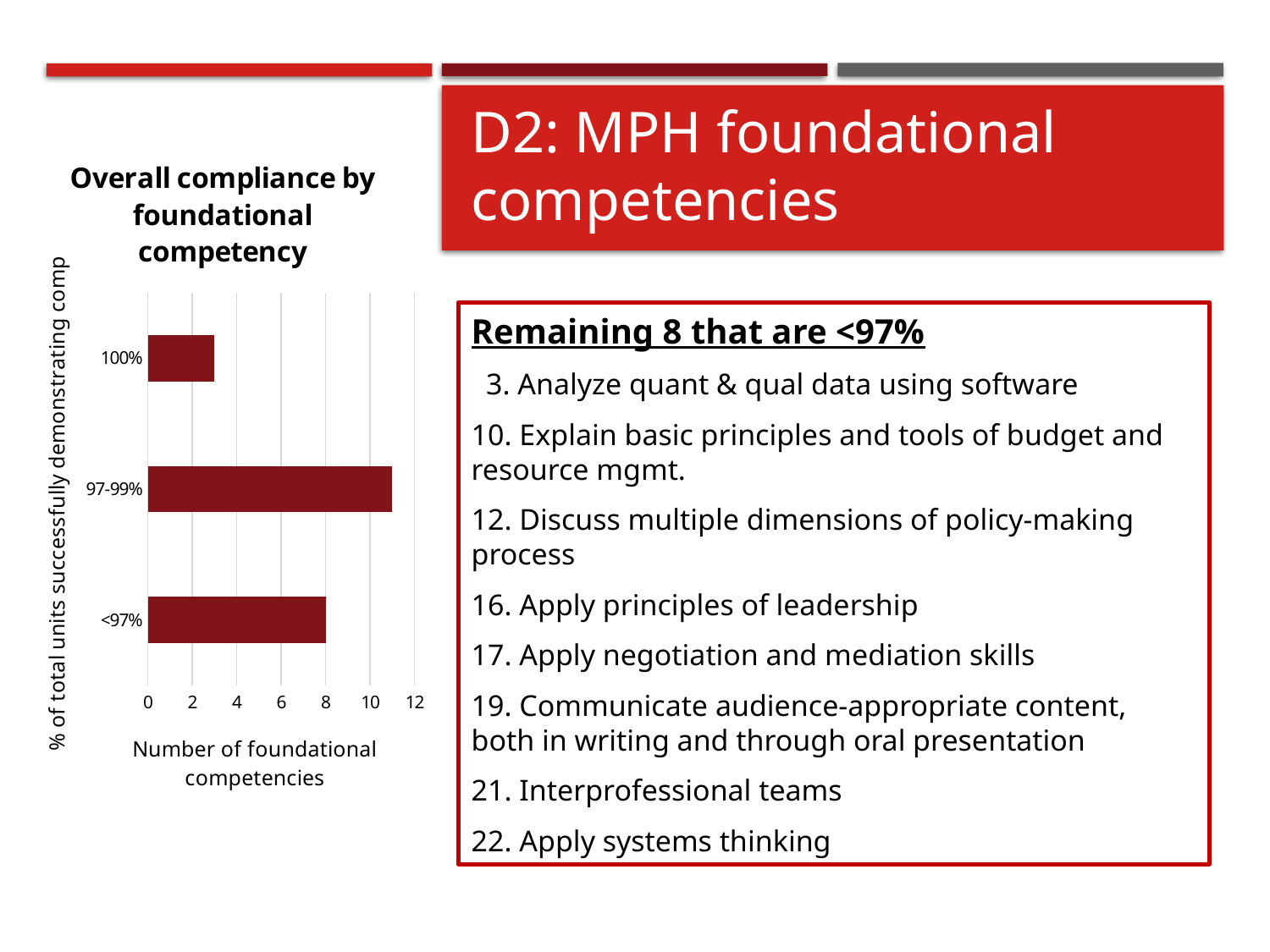
Which category has more foundational competencies, <97% or 100%? <97% What is the label of the horizontal axis of the chart? Number of foundational competencies What kind of chart is shown on the slide? bar chart What is the title of the chart? Overall compliance by foundational competency How many foundational competencies fall in the <97% category? 8 Which category has the lowest number of foundational competencies? 100% Which category has the highest number of foundational competencies? 97-99% How many categories are plotted in the chart? 3 Is the value for the 100% category greater or less than 4? less Is the value for the <97% category greater or less than 6? greater Which category has more foundational competencies, 97-99% or <97%? 97-99% Is the value for the 97-99% category greater or less than 10? greater